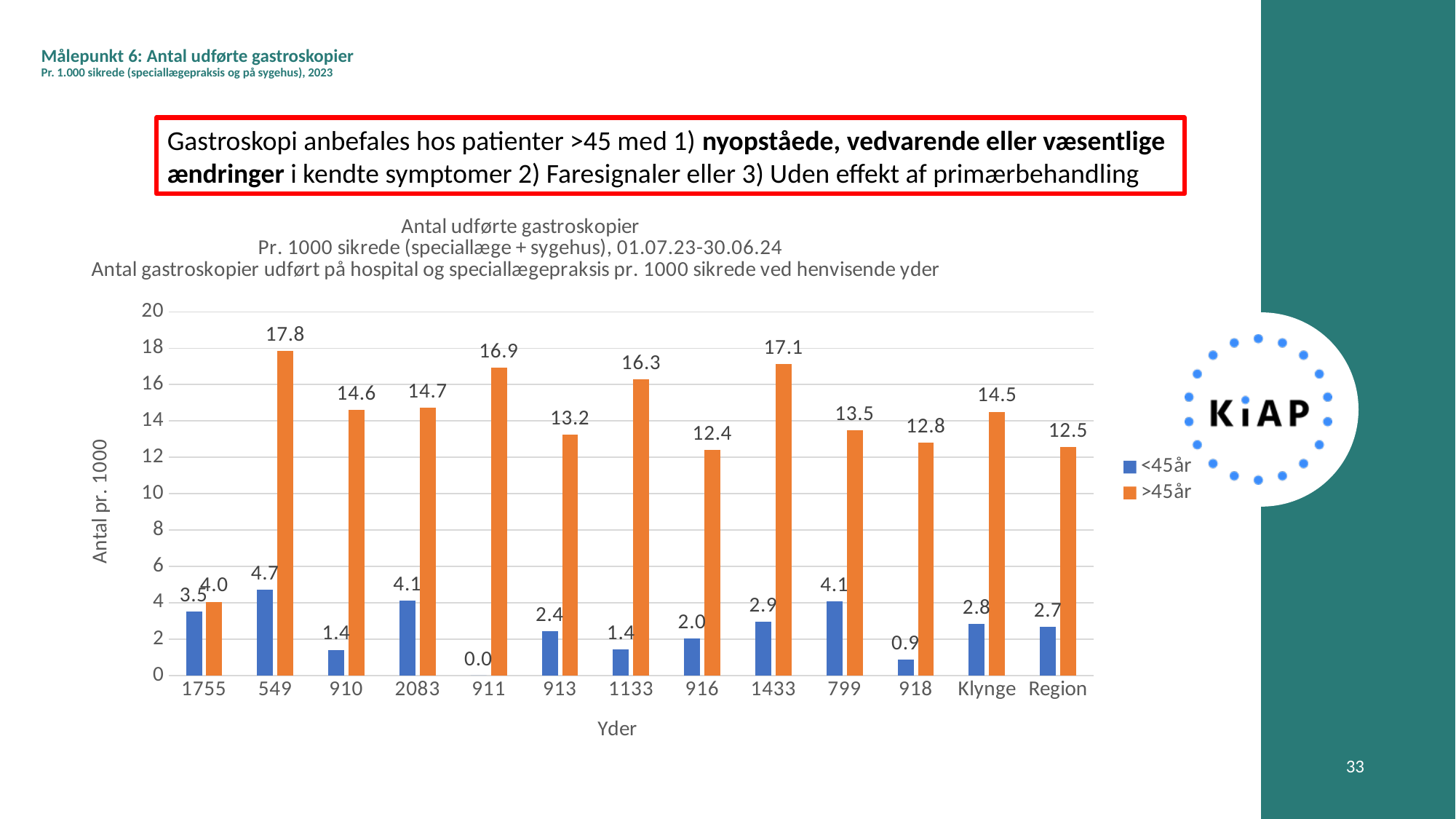
What is the value for >45år for yder 549? 17.8 Which is larger for yder 1433: the <45år value or the >45år value? >45år What is the difference between the >45år and <45år values for yder 549? 13.1 What is the value for <45år for yder 2083? 4.1 What is the value for >45år for Region? 12.5 Which yder has the lowest value for <45år? 911 Which yder has the highest value for >45år? 549 Which yder has the lowest value for >45år? 1755 What is the value for <45år for yder 911? 0.0 How many categories are shown on the x axis? 13 What kind of chart is shown on the slide? Bar chart How many series does the legend list? 2